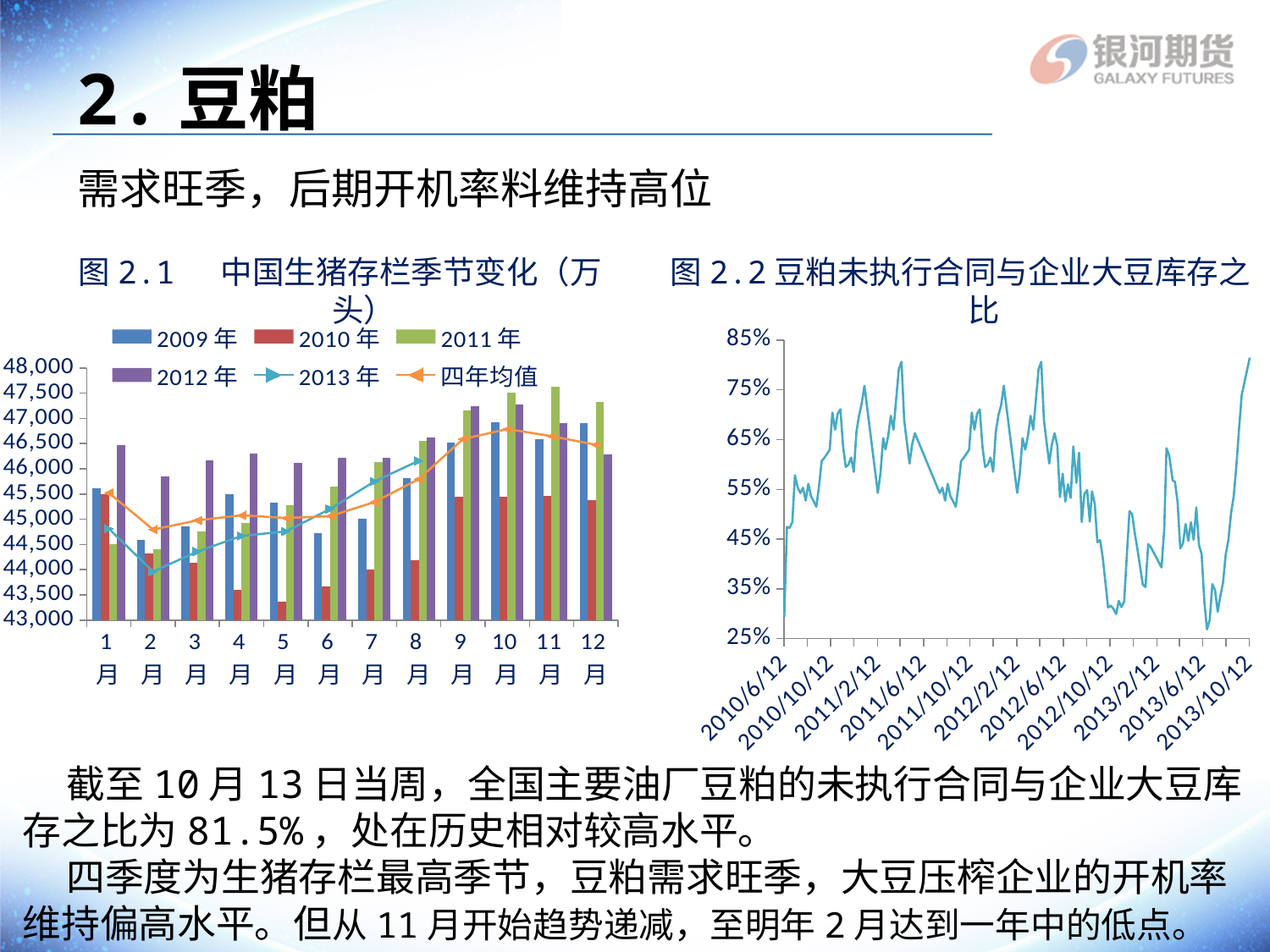
In the chart 图2.1 中国生猪存栏季节变化（万头）, is the 2012年 value for 1月 greater or less than 46,000? greater In the chart 图2.1 中国生猪存栏季节变化（万头）, in 2月, which is larger: the 2012年 bar or the 2009年 bar? 2012年 In the chart 图2.2 豆粕未执行合同与企业大豆库存之比, what is the highest tick shown on the y axis? 85% In the chart 图2.1 中国生猪存栏季节变化（万头）, which year has the highest bar in 11月? 2011年 In the chart 图2.2 豆粕未执行合同与企业大豆库存之比, does the line rise or fall between 2013/6/12 and 2013/10/12? rise In the chart 图2.1 中国生猪存栏季节变化（万头）, how many months are shown on the x axis? 12 In the chart 图2.1 中国生猪存栏季节变化（万头）, which year has the lowest bar in 1月? 2011年 In the chart 图2.1 中国生猪存栏季节变化（万头）, which legend entry is drawn with orange triangle markers? 四年均值 In the chart 图2.2 豆粕未执行合同与企业大豆库存之比, is the value at 2013/10/12 greater or less than 75%? greater In the chart 图2.1 中国生猪存栏季节变化（万头）, is the 2009年 value for 6月 greater or less than 45,000? less In the chart 图2.2 豆粕未执行合同与企业大豆库存之比, what kind of chart is it? line chart In the chart 图2.1 中国生猪存栏季节变化（万头）, how many series does the legend list? 6